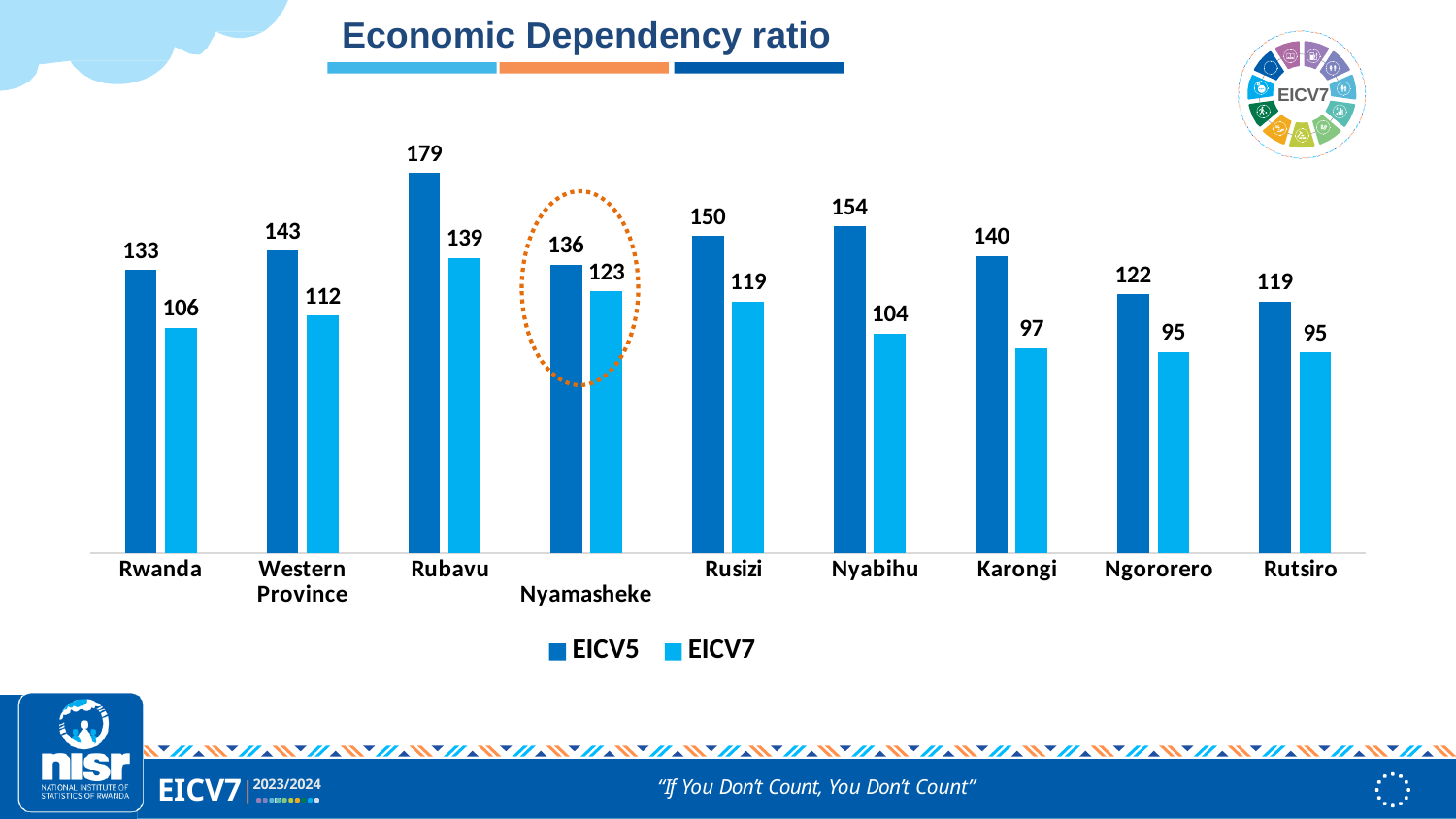
What is the difference between the EICV5 and EICV7 values for Nyabihu? 50 Which category is highlighted with a dotted orange circle? Nyamasheke What is the title of the chart? Economic Dependency ratio How many series does the legend list? 2 Which category has the highest EICV5 value? Rubavu What is the EICV7 economic dependency ratio for Rwanda? 106 How many categories are shown on the x axis? 9 What is the EICV5 economic dependency ratio for Nyamasheke? 136 What is the EICV7 value for Rubavu? 139 Which category has the lowest EICV5 value? Rutsiro Which is larger for Karongi: the EICV5 value or the EICV7 value? EICV5 What kind of chart is shown on the slide? Bar chart